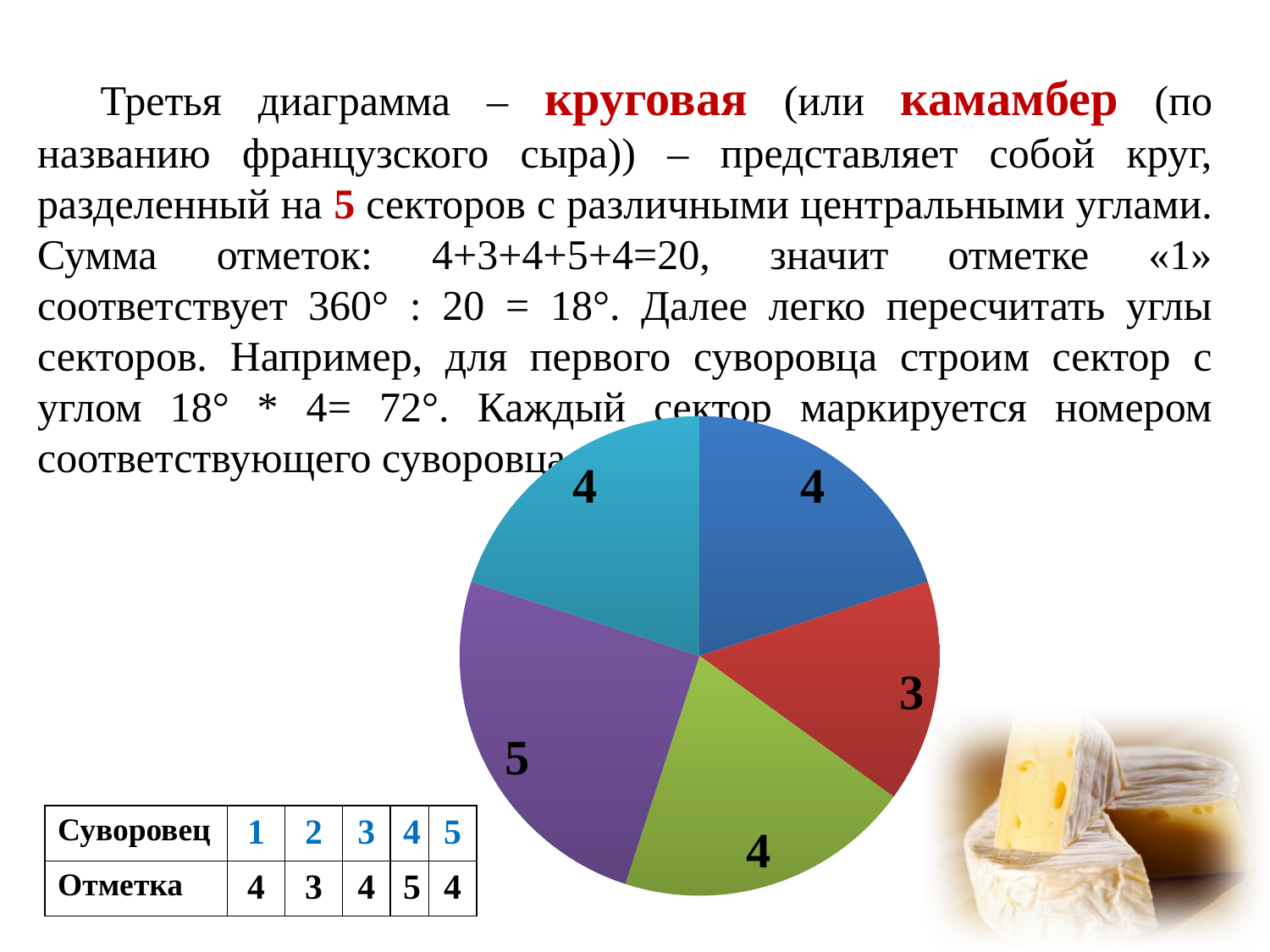
What kind of chart is shown on the slide? pie chart What share of the pie does the purple sector (value 5) represent? 25% What is the difference between the largest and smallest sector values in the pie chart? 2 What value is printed on the purple sector of the pie chart? 5 What value is printed on the blue sector of the pie chart? 4 What share of the pie does the red sector (value 3) represent? 15% Which sector of the pie chart has the smallest value? the red sector (3) What is the total of all the sector values in the pie chart? 20 How many sectors does the pie chart have? 5 Which is larger, the value of the purple sector or the value of the green sector? the purple sector Which sector of the pie chart has the largest value? the purple sector (5) What value is printed on the red sector of the pie chart? 3